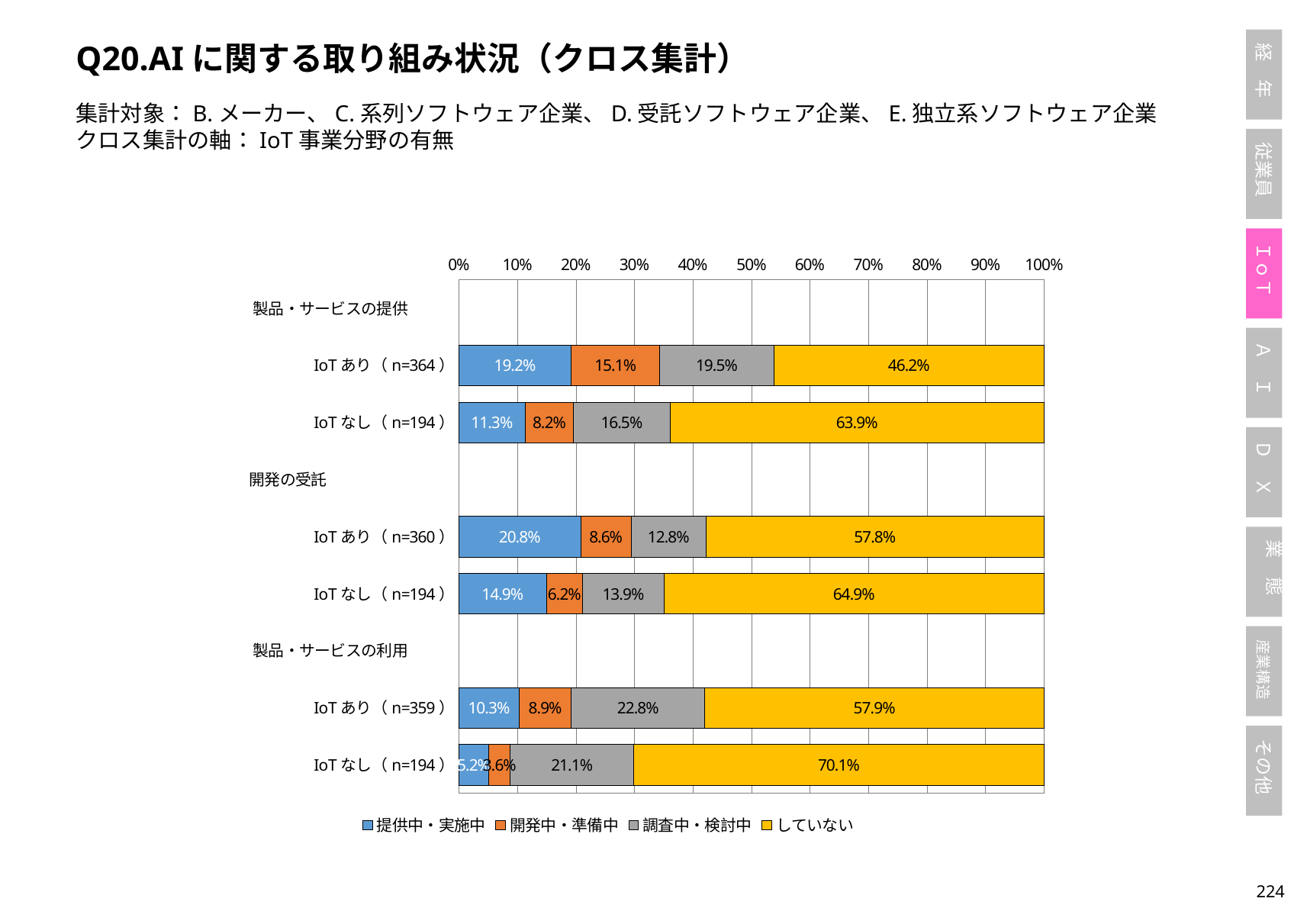
What is the value of 調査中・検討中 for IoTあり (n=359) under 製品・サービスの利用? 22.8% Which is larger: 開発中・準備中 for IoTあり (n=364) under 製品・サービスの提供 or 開発中・準備中 for IoTあり (n=360) under 開発の受託? IoTあり (n=364) under 製品・サービスの提供 Is the value of していない for IoTなし (n=194) under 開発の受託 greater or less than 60%? greater What is the value of 提供中・実施中 for IoTあり (n=360) under 開発の受託? 20.8% What is the difference in していない between IoTなし (n=194) and IoTあり (n=364) under 製品・サービスの提供? 17.7% Which bar has the highest value for していない? IoTなし (n=194) under 製品・サービスの利用 What is the value of していない for IoTなし (n=194) under 製品・サービスの利用? 70.1% How many series does the legend list? 4 What kind of chart is shown on the slide? Stacked bar chart Which colour represents していない in the chart? Yellow Which bar has the lowest value for していない? IoTあり (n=364) under 製品・サービスの提供 What is the value of していない for IoTあり (n=364) under 製品・サービスの提供? 46.2%